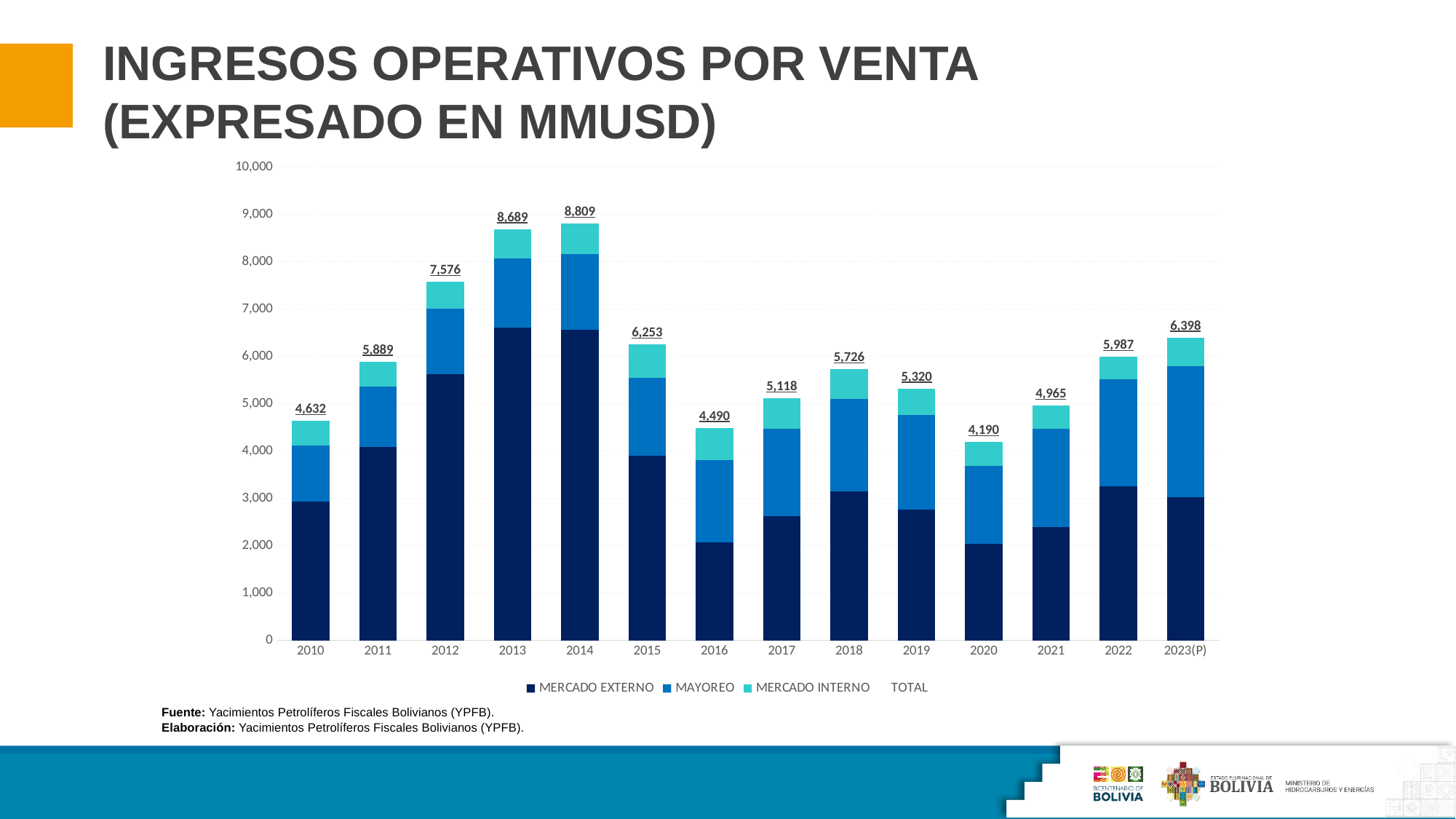
What is the difference between the totals for 2023(P) and 2022? 411 Which year has the highest total? 2014 What kind of chart is shown on the slide? Stacked bar chart Which year has the lowest total? 2020 Is the MERCADO EXTERNO value for 2016 greater or less than 3,000? less What is the difference between the totals for 2014 and 2013? 120 What is the total value shown for 2023(P)? 6,398 What is the total value shown for 2014? 8,809 How many entries does the legend list? 4 Is the MERCADO EXTERNO value for 2013 greater or less than 6,000? greater How many years are shown on the x axis? 14 Which total is larger, 2018 or 2019? 2018